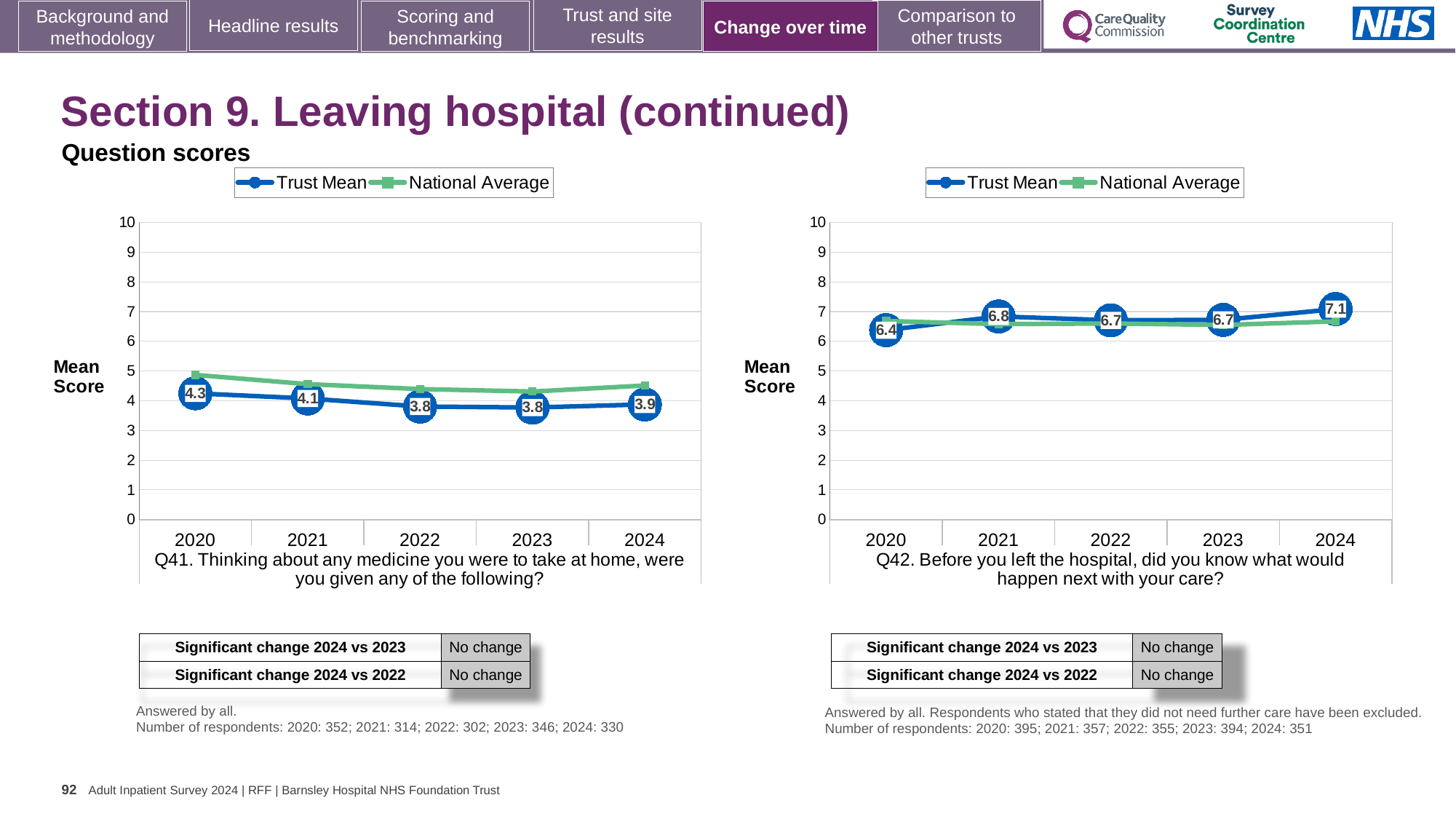
On the Q41 chart (left), what is the Trust Mean score for 2020? 4.3 How many years are shown on the x axis of the Q42 chart (right)? 5 On the Q42 chart (right), in which year is the Trust Mean score highest? 2024 On the Q41 chart (left), is the National Average for 2020 greater or less than 4? greater On the Q42 chart (right), what is the Trust Mean score for 2021? 6.8 On the Q41 chart (left), what is the Trust Mean score for 2024? 3.9 How many series does the legend of the Q41 chart (left) list? 2 On the Q41 chart (left), what is the difference between the Trust Mean score in 2020 and in 2024? 0.4 On the Q42 chart (right), in which year is the Trust Mean score lowest? 2020 On the Q41 chart (left), which is larger in 2020: the Trust Mean or the National Average? National Average What type of chart is used for Q42 (right)? Line chart On the Q42 chart (right), what is the difference between the Trust Mean score in 2024 and in 2020? 0.7